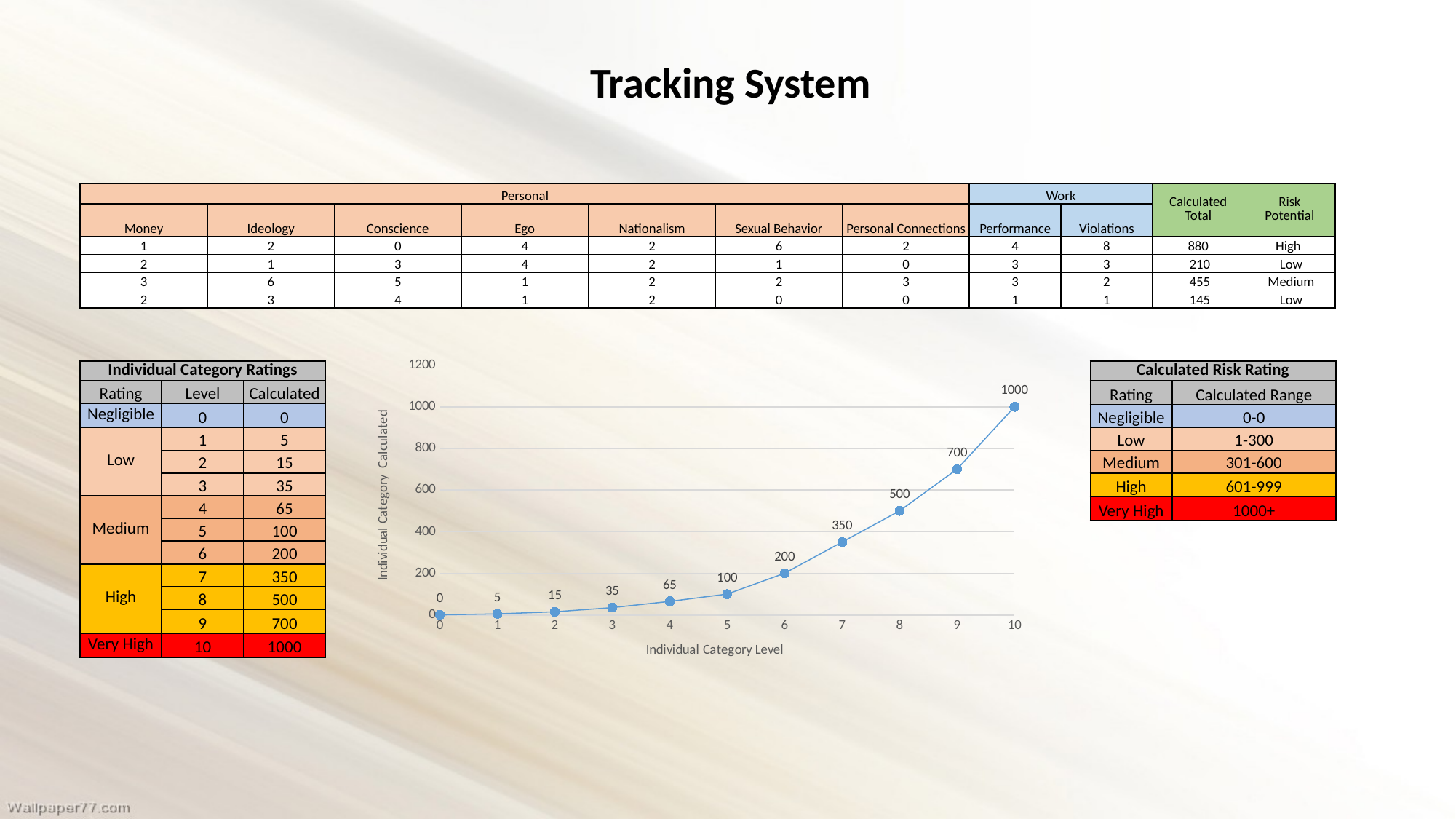
What is the title of the x axis of the line chart? Individual Category Level In the line chart, what is the calculated value at Individual Category Level 4? 65 In the line chart, which Individual Category Level has the highest calculated value? 10 In the line chart, what is the calculated value at Individual Category Level 10? 1000 In the line chart, which is larger: the calculated value at level 3 or at level 5? level 5 In the line chart, what is the difference between the calculated values at level 9 and level 8? 200 In the line chart, what is the difference between the calculated values at level 6 and level 5? 100 What type of chart is shown on the slide? line chart In the line chart, which Individual Category Level has the lowest calculated value? 0 Do the values in the line chart rise or fall as the Individual Category Level increases? rise How many data points are plotted in the line chart? 11 In the line chart, what is the calculated value at Individual Category Level 7? 350